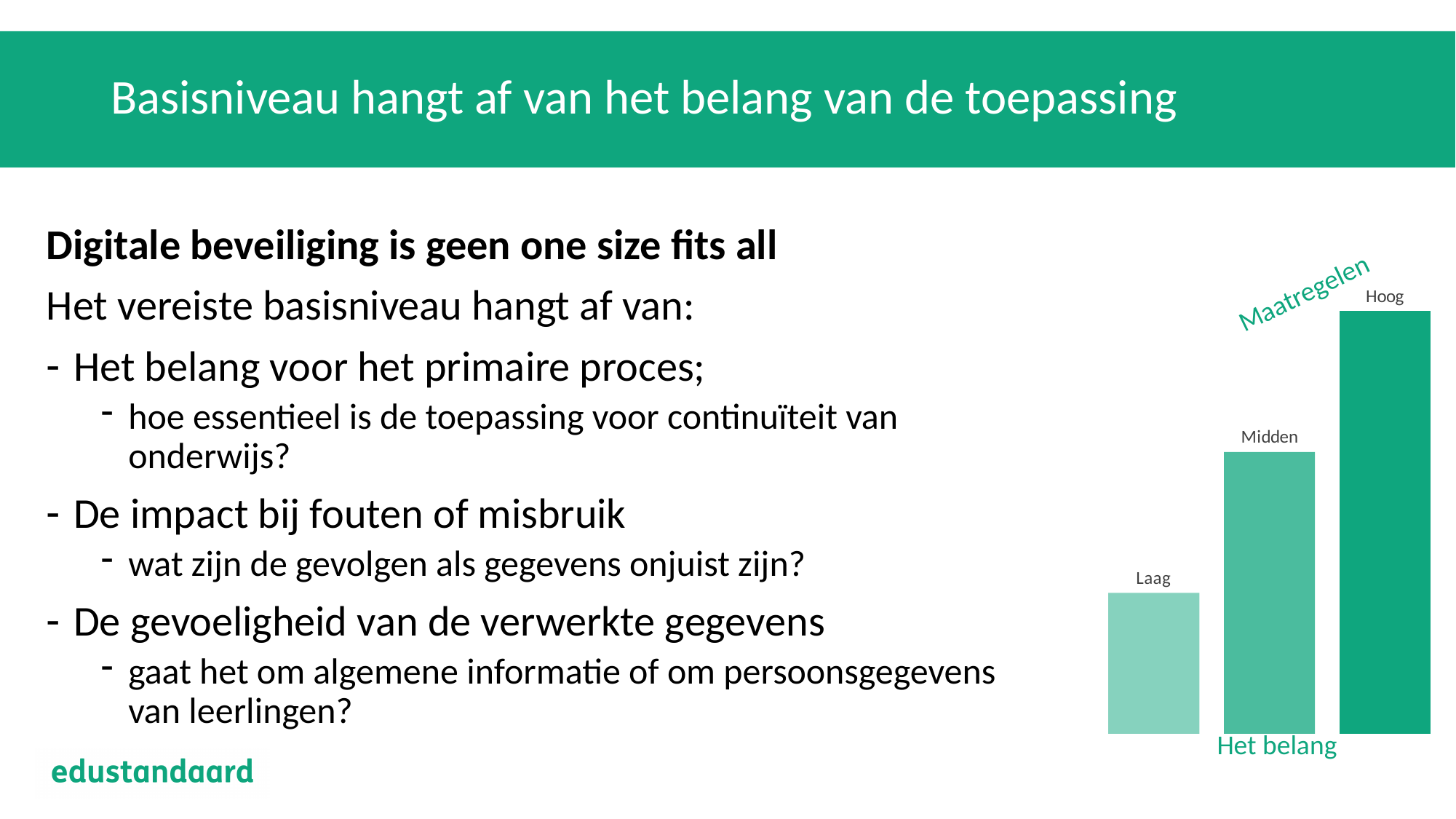
Which category has the tallest bar in the chart? Hoog What label is written along the vertical axis of the chart? Maatregelen Which bar is taller, Midden or Laag? Midden What kind of chart is shown on the right of the slide? bar chart What are the three category labels on the chart, from left to right? Laag, Midden, Hoog Which bar is taller, Hoog or Midden? Hoog How many bars does the chart show? 3 Which category has the shortest bar in the chart? Laag What label is written along the horizontal axis of the chart? Het belang Do the bars rise or fall from left to right across the chart? rise